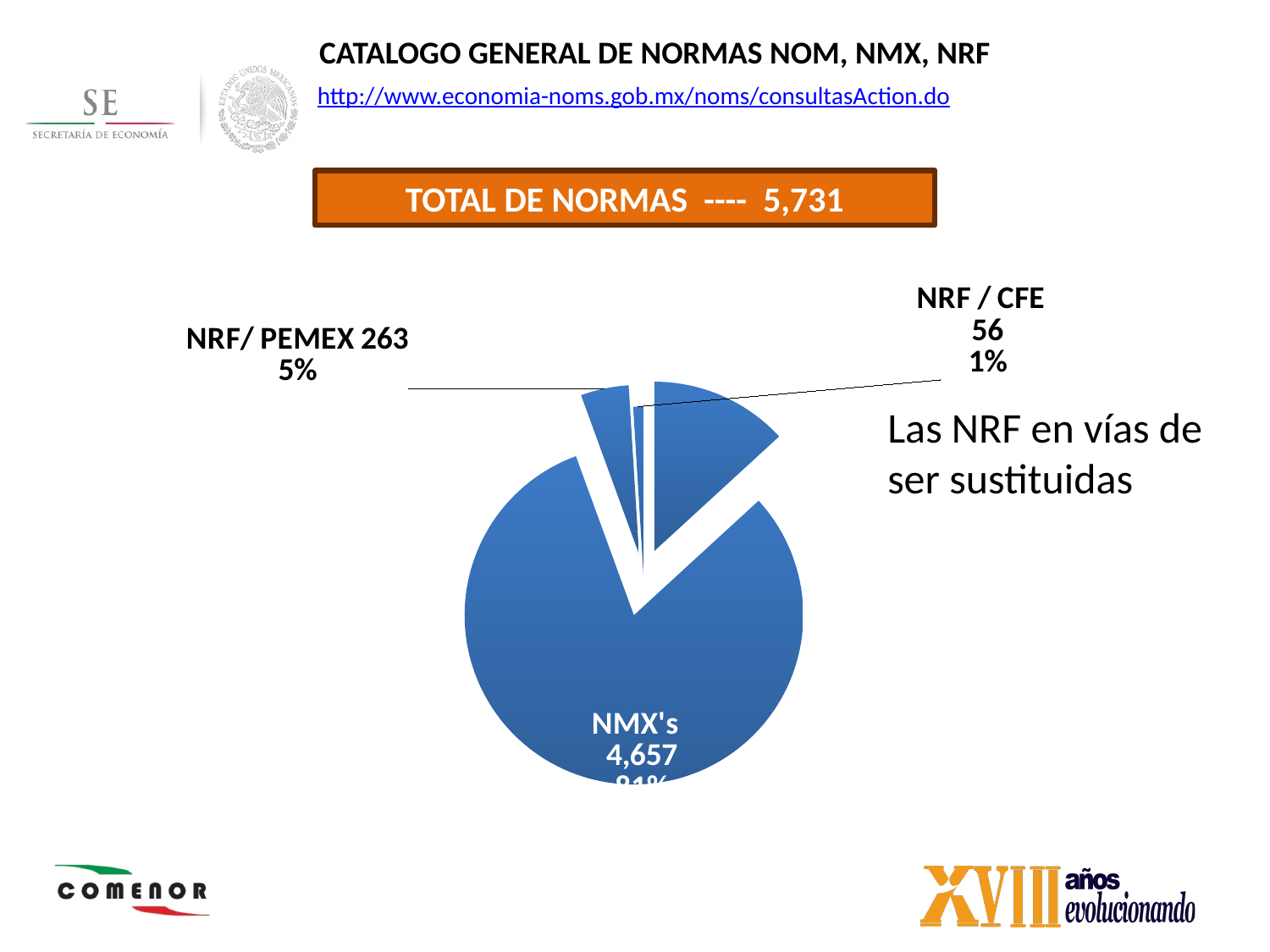
Which slice of the pie is the smallest? NRF / CFE What is the value shown for the NRF / CFE slice? 56 What is the difference between the NMX's value and the NRF/ PEMEX value? 4,394 Which labeled slice of the pie is the largest? NMX's Which is larger, the NRF/ PEMEX slice or the NRF / CFE slice? NRF/ PEMEX What share of the pie does the NRF/ PEMEX slice represent? 5% What is the value shown for the NRF/ PEMEX slice? 263 What share of the pie does the NRF / CFE slice represent? 1% What is the value shown for the NMX's slice? 4,657 How many slices of the pie have a readable label? 3 What is the difference between the NRF/ PEMEX value and the NRF / CFE value? 207 What kind of chart is shown on the slide? pie chart